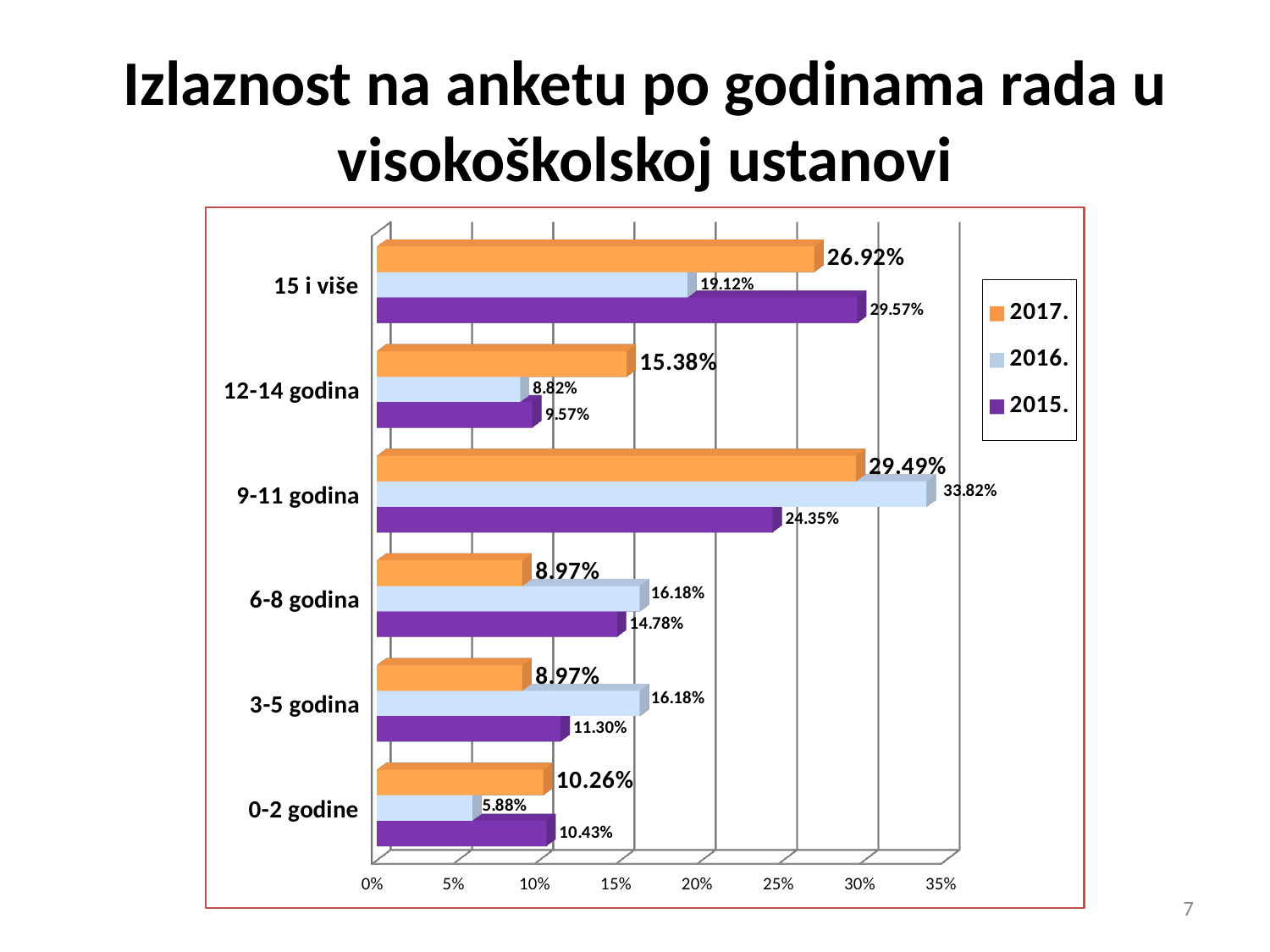
How many categories are shown on the chart? 6 What kind of chart is shown on the slide? Bar chart What is the value for 2016. in the 0-2 godine category? 5.88% Which category has the lowest value for the 2015. series? 12-14 godina Which category has the highest value for the 2016. series? 9-11 godina What is the value for 2015. in the 15 i više category? 29.57% What is the difference between the 2017. and 2016. values in the 12-14 godina category? 6.56% How many series does the legend list? 3 Which series is shown in orange in the legend? 2017. What is the value for 2017. in the 9-11 godina category? 29.49% Which is larger in the 6-8 godina category: the 2016. value or the 2015. value? 2016. What is the difference between the 2015. and 2016. values in the 9-11 godina category? 9.47%